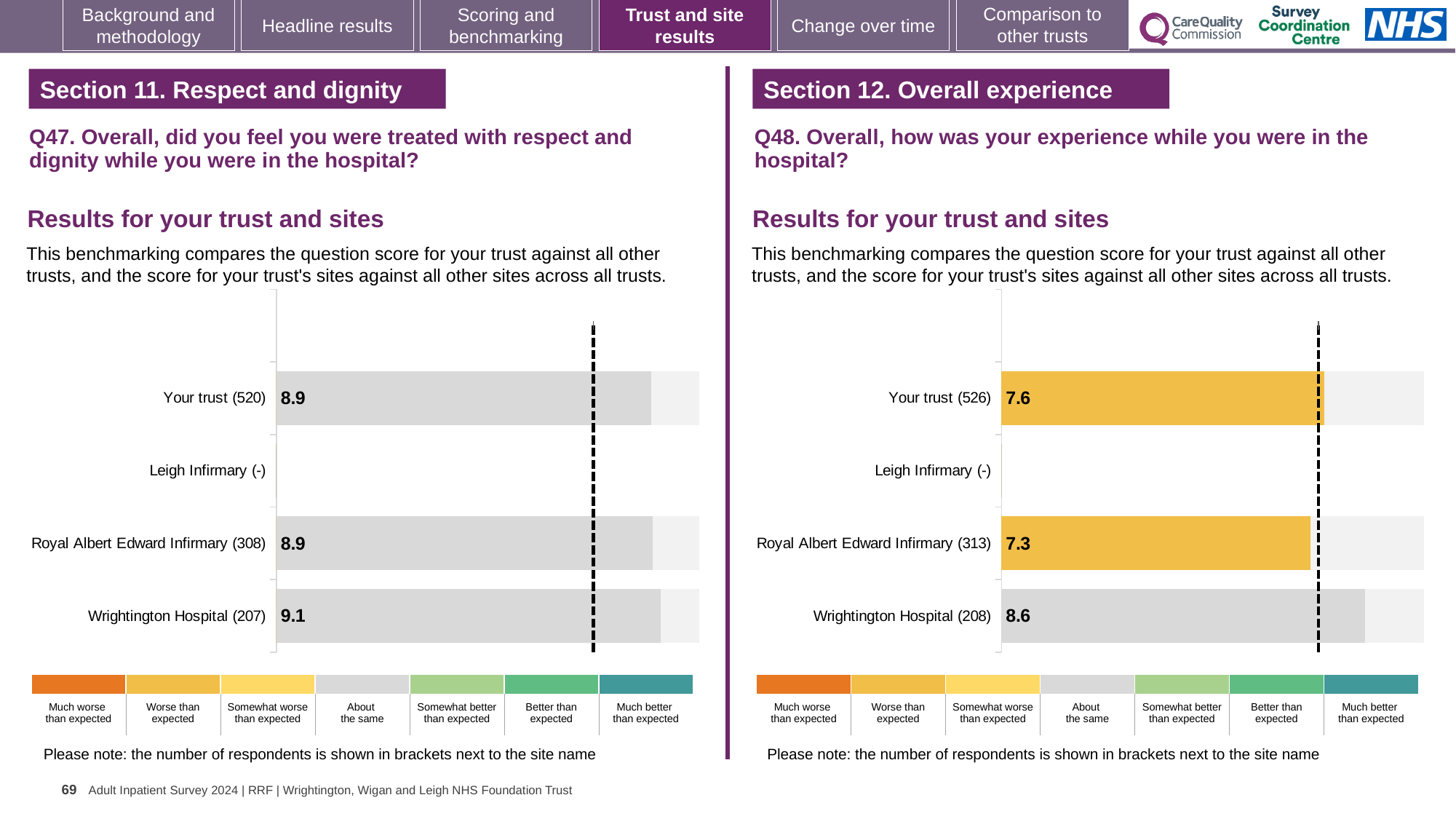
In the Q48 chart on the right, what is the difference between the scores for Wrightington Hospital and Royal Albert Edward Infirmary? 1.3 How many respondents are shown in brackets for Your trust in the Q48 chart on the right? 526 In the Q47 chart on the left, what is the difference between the scores for Wrightington Hospital and Your trust? 0.2 In the Q48 chart on the right, which site or trust has the lowest score shown? Royal Albert Edward Infirmary In the Q48 chart on the right, what is the score for Wrightington Hospital? 8.6 What kind of chart is used for the Q47 results on the left? Bar chart In the Q47 chart on the left, what is the score for Your trust? 8.9 In the Q47 chart on the left, what is the score for Wrightington Hospital? 9.1 In the Q48 chart on the right, which site or trust has the highest score? Wrightington Hospital In the Q48 chart on the right, what is the score for Royal Albert Edward Infirmary? 7.3 In the Q48 chart on the right, which has the larger score, Your trust or Royal Albert Edward Infirmary? Your trust In the Q48 chart on the right, what colour are the bars for Your trust and Royal Albert Edward Infirmary? Yellow/orange (Worse than expected)